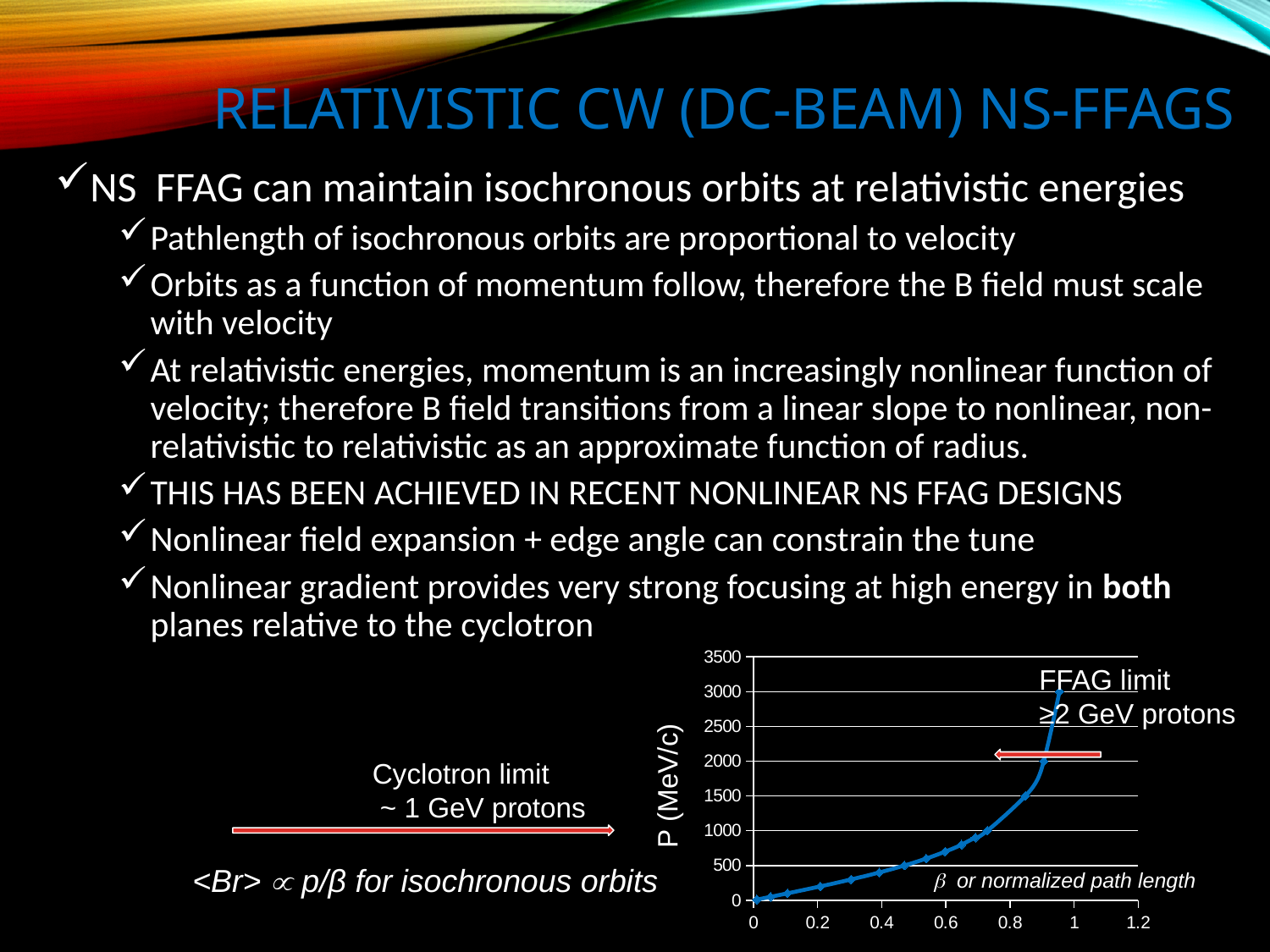
Which has the larger value of P: the point at β = 0.9 or the point at β = 0.5? β = 0.9 What is the highest tick value shown on the vertical axis of the chart? 3500 Is the value of P at β = 0.6 greater or less than 1000 MeV/c? less Is the value of P at β = 0.4 greater or less than 500 MeV/c? less What kind of chart is shown on the slide? line chart Is the value of P at β = 0.8 greater or less than 1000 MeV/c? greater What is the label of the horizontal axis of the chart? β or normalized path length What is the label of the vertical axis of the chart? P (MeV/c) At which end of the x axis, low β or high β, is the plotted momentum P at its maximum? high β Does the plotted momentum P rise or fall as β increases along the x axis? rises